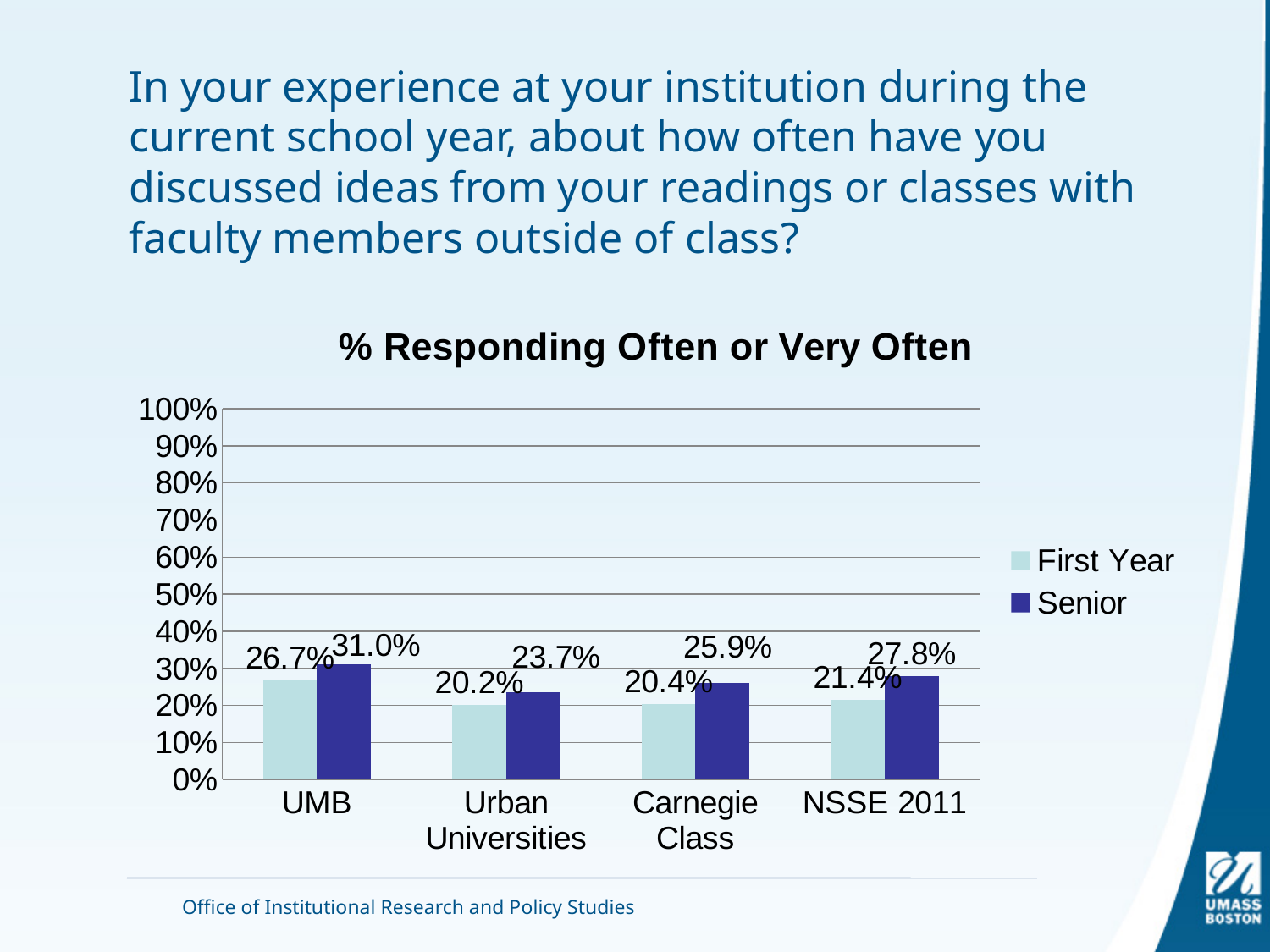
Which category has the lowest First Year value? Urban Universities Which category has the highest Senior value? UMB What is the Senior value for Carnegie Class? 25.9% What is the Senior value for NSSE 2011? 27.8% What kind of chart is shown? bar chart Is the Senior value for Urban Universities greater or less than 30%? less How many series does the legend list? 2 Which is larger, the First Year value for Carnegie Class or the First Year value for NSSE 2011? NSSE 2011 What is the title of the chart? % Responding Often or Very Often What is the difference between the Senior and First Year values for UMB? 4.3% What is the First Year value for UMB? 26.7% How many categories are shown on the x axis? 4